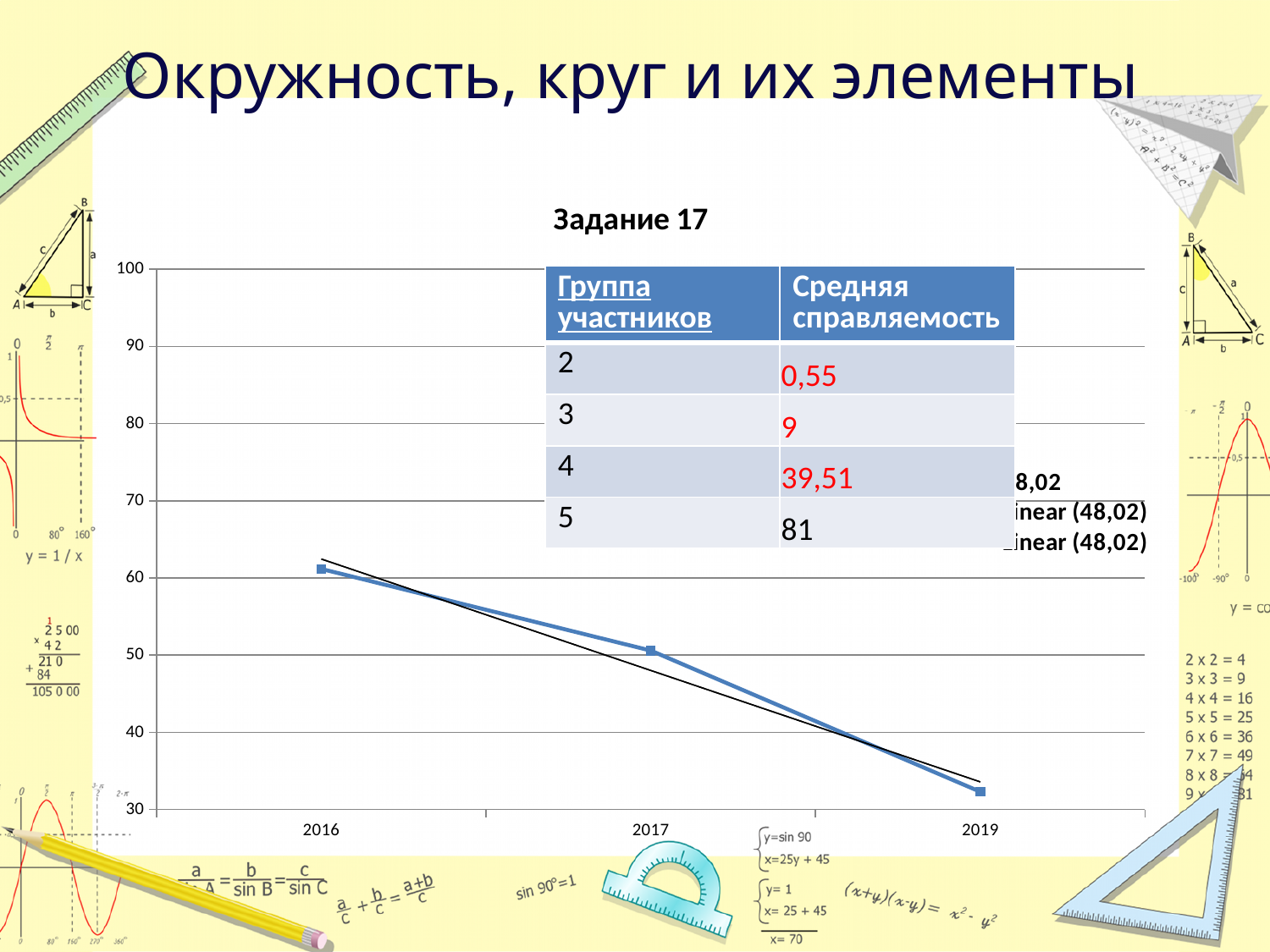
What kind of chart is shown under the title "Задание 17"? line chart Is the value for 2017 greater or less than 40? greater Which year has the highest value on the chart? 2016 What is the title of the chart? Задание 17 Which year has the lowest value on the chart? 2019 Is the value for 2019 greater or less than 40? less Is the value for 2016 greater or less than 70? less Which is larger, the value for 2017 or the value for 2019? 2017 What is the lowest value shown on the vertical axis of the chart? 30 How many data points are plotted on the line in the chart? 3 Do the values rise or fall from 2016 to 2019 along the x axis? fall